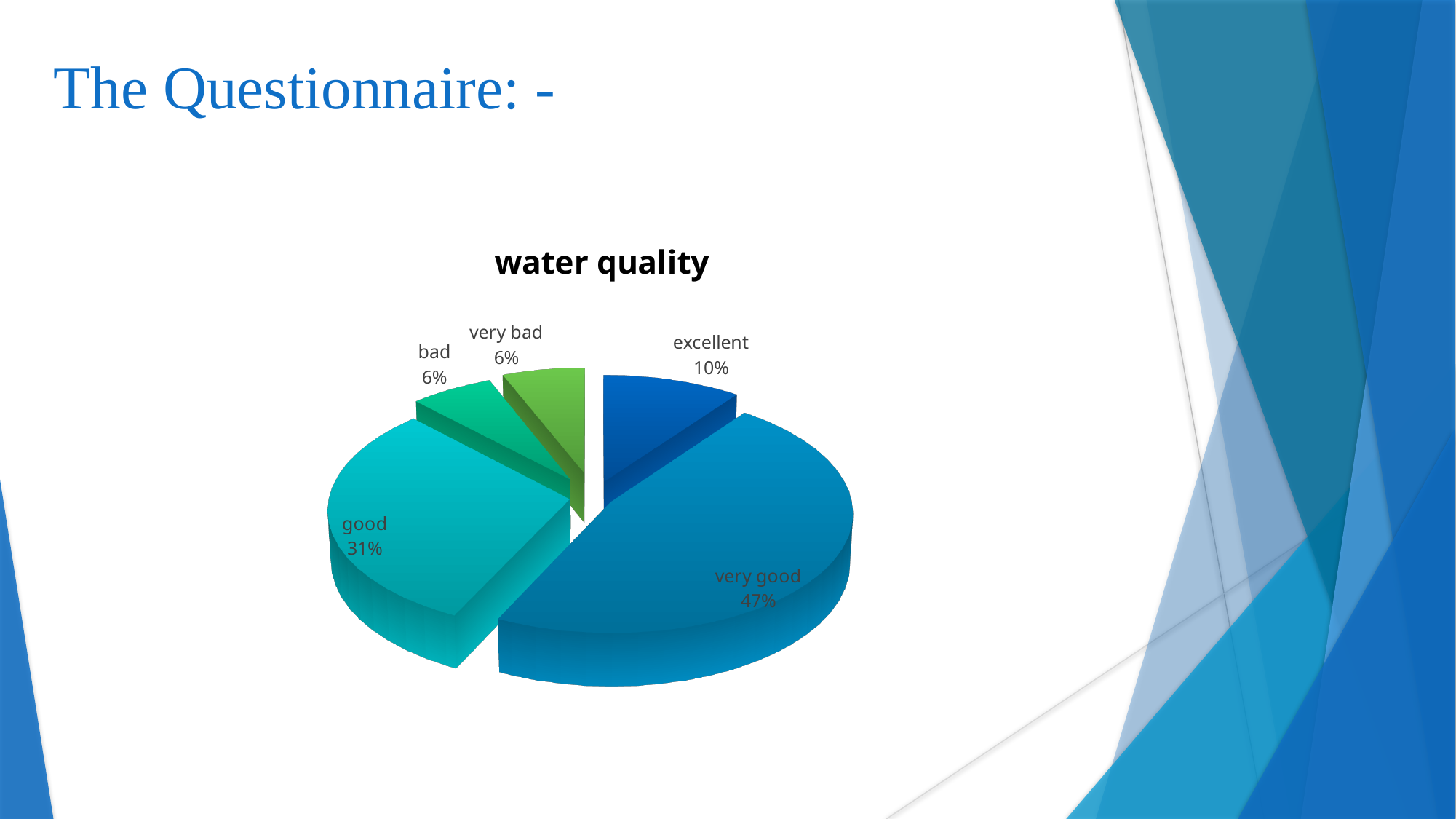
What is the value shown for 'excellent'? 10% What share of the pie does 'very good' represent? 47% What is the title of the chart? water quality What kind of chart is shown on the slide? pie chart What is the difference between the 'very good' and 'good' slices? 16% What is the difference between the 'excellent' and 'bad' slices? 4% Which category has the largest slice of the pie? very good How many categories are shown in the pie chart? 5 What is the combined share of the 'bad' and 'very bad' slices? 12% What is the value shown for 'bad'? 6% Which is larger, the 'excellent' slice or the 'good' slice? good What is the value shown for 'good'? 31%